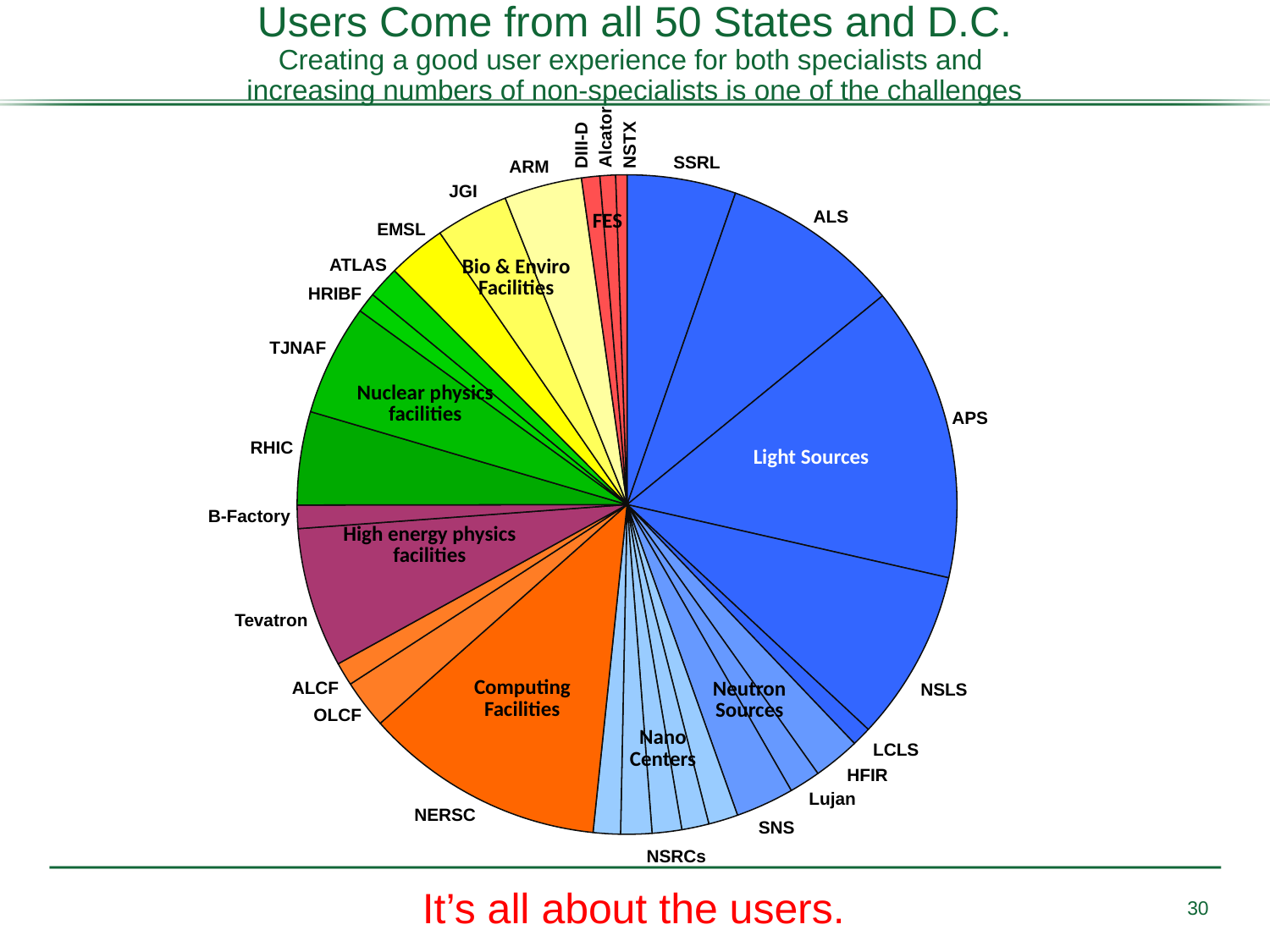
Which slice is larger, APS or NERSC? APS What kind of chart is shown on the slide? pie chart Which facility group takes up a larger share of the pie, Light Sources or Computing Facilities? Light Sources Which slice is larger, TJNAF or HRIBF? TJNAF What colour are the Light Sources slices in the pie chart? blue Which facility has the largest slice of the pie? APS Which facility group is shown in red in the pie chart? FES